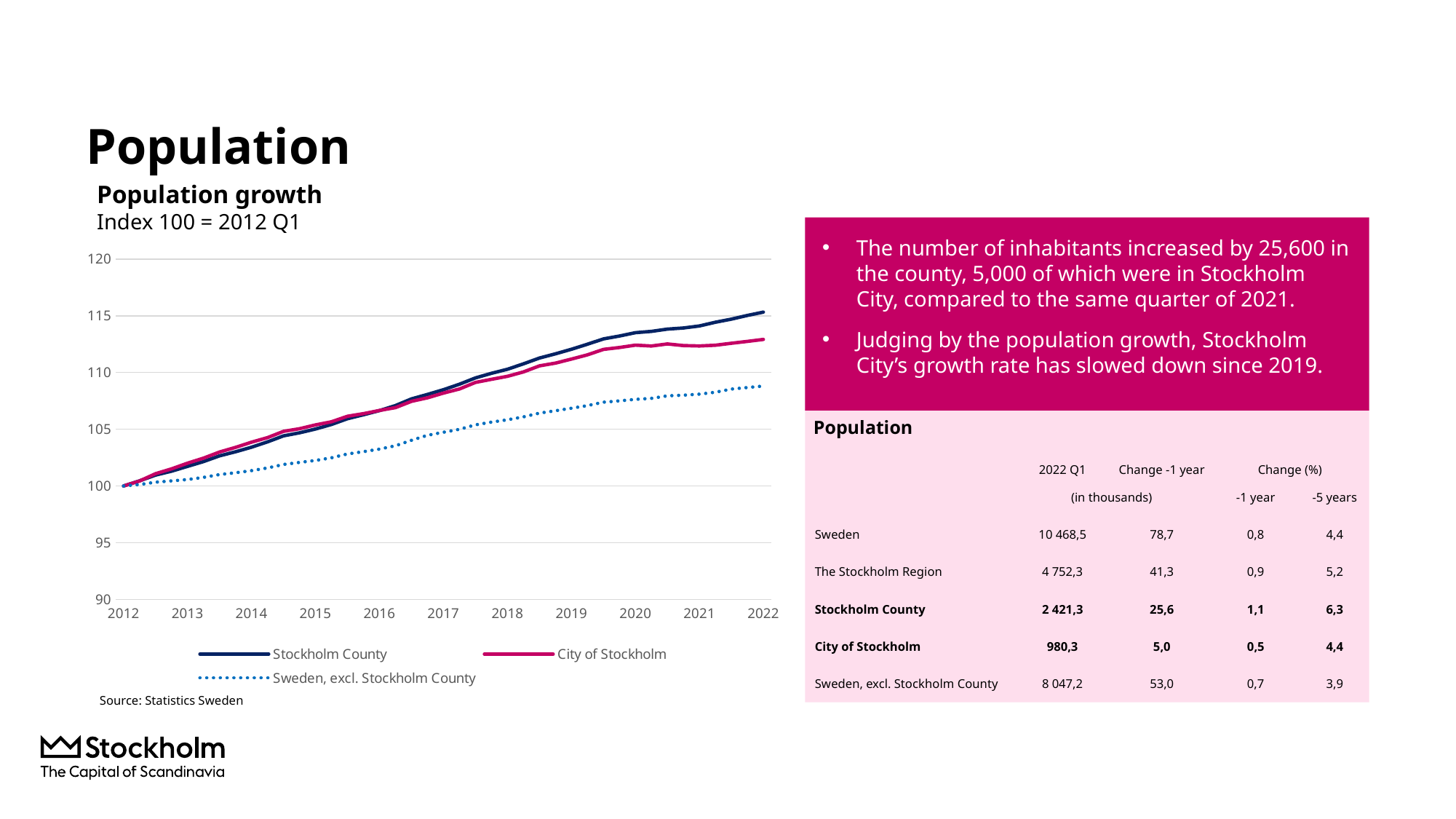
How many years are labelled on the x axis of the "Population growth" chart? 11 In the "Population growth" chart, is the value for Sweden, excl. Stockholm County in 2022 greater or less than 110? less In the "Population growth" chart, is the value for City of Stockholm in 2022 greater or less than 110? greater How many series does the legend of the "Population growth" chart list? 3 In the "Population growth" chart, do the values for Stockholm County rise or fall from 2012 to 2022? rise Which series in the "Population growth" chart has the lowest value in 2022? Sweden, excl. Stockholm County Which series in the "Population growth" chart is drawn with a dotted line? Sweden, excl. Stockholm County In the "Population growth" chart, is the value for Sweden, excl. Stockholm County in 2016 greater or less than 105? less In the "Population growth" chart, which is higher in 2022: Stockholm County or City of Stockholm? Stockholm County Which series in the "Population growth" chart has the highest value in 2022? Stockholm County What kind of chart is shown under the heading "Population growth"? line chart What is the index value of all three series at the start of the "Population growth" chart in 2012 Q1? 100